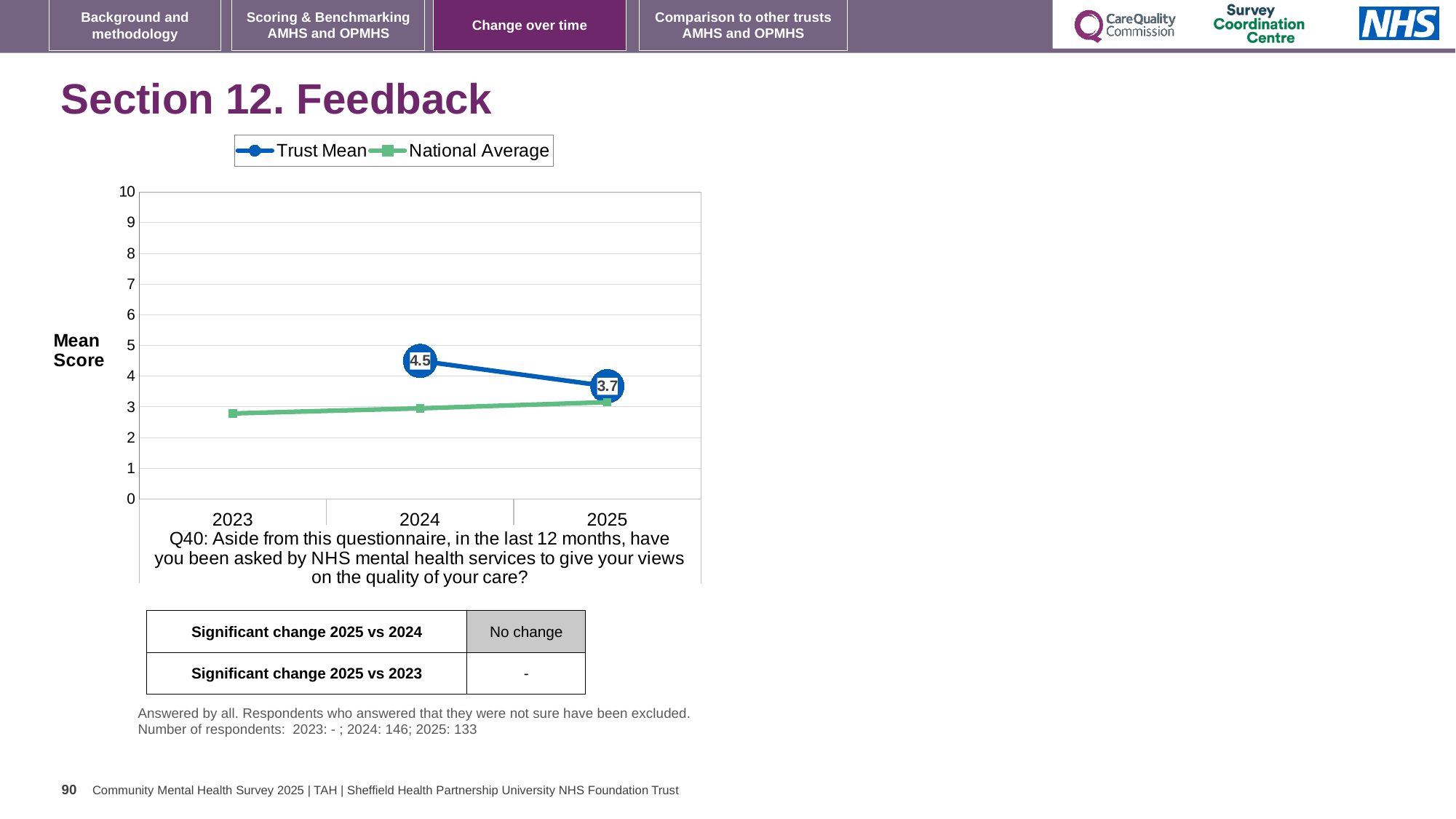
By how much did the Trust Mean score fall from 2024 to 2025? 0.8 What is the Trust Mean score for 2024? 4.5 Is the Trust Mean value for 2024 greater or less than 4? greater Which year has the higher Trust Mean score, 2024 or 2025? 2024 What is the Trust Mean score for 2025? 3.7 Does the National Average line rise or fall from 2023 to 2025? rise In 2025, which is higher, the Trust Mean or the National Average? Trust Mean Does the Trust Mean line rise or fall from 2024 to 2025? fall How many years are shown on the x axis of the chart? 3 How many series does the legend list? 2 What kind of chart is shown on the slide? line chart Is the National Average value for 2023 greater or less than 4? less